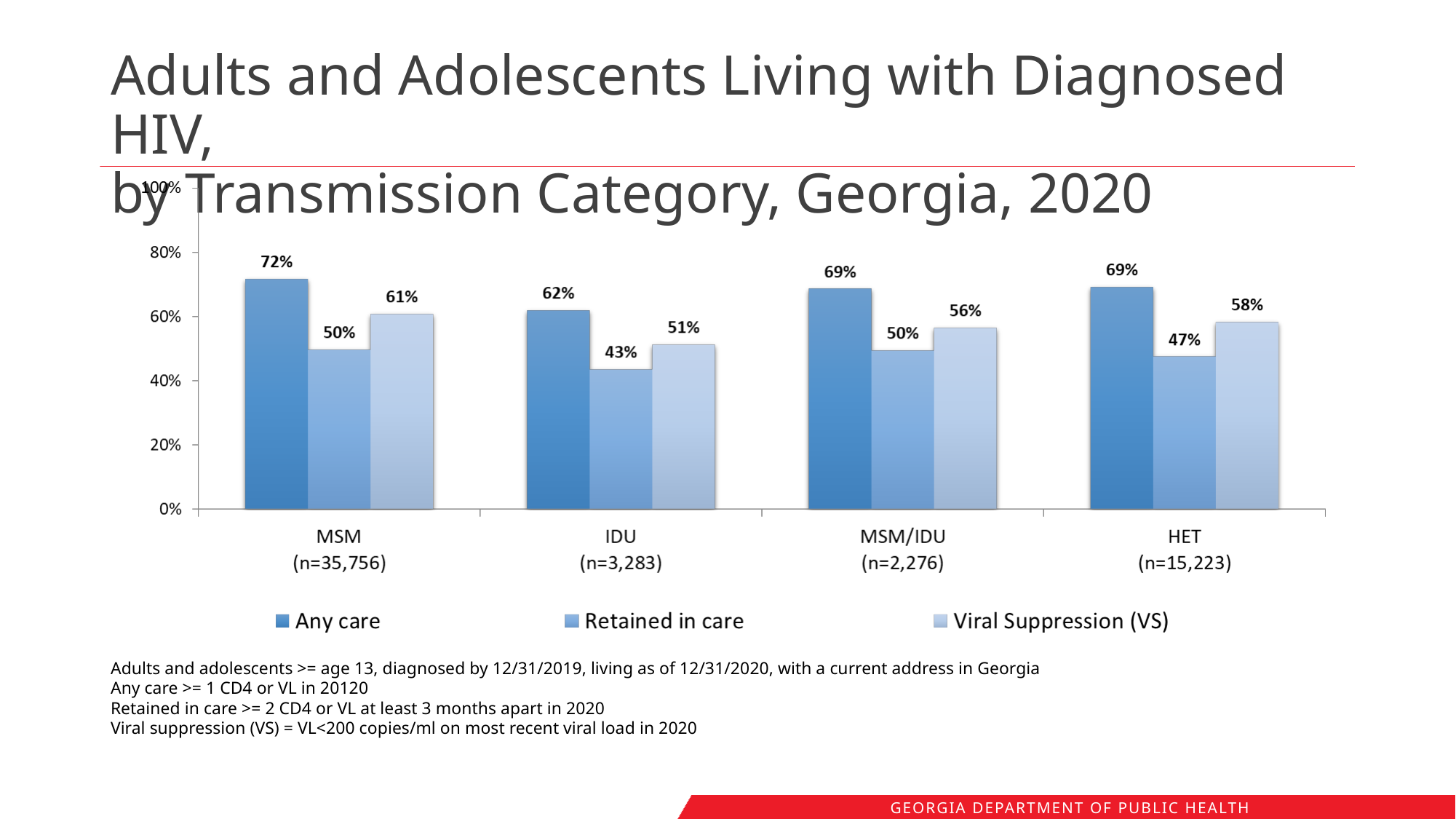
How many transmission categories are shown on the x axis? 4 What is the third legend entry? Viral Suppression (VS) What kind of chart is shown on the slide? Bar chart What is the sample size (n) shown for the HET group? 15,223 What percentage of the MSM group received any care? 72% What is the Retained in care value for the IDU group? 43% How many series does the legend list? 3 Which transmission category has the lowest Retained in care percentage? IDU Which is larger, the Viral Suppression (VS) value for MSM or for IDU? MSM What is the Viral Suppression (VS) value for the HET group? 58% What is the difference between the Any care and Retained in care percentages for the MSM/IDU group? 19% Which transmission category has the highest Any care percentage? MSM